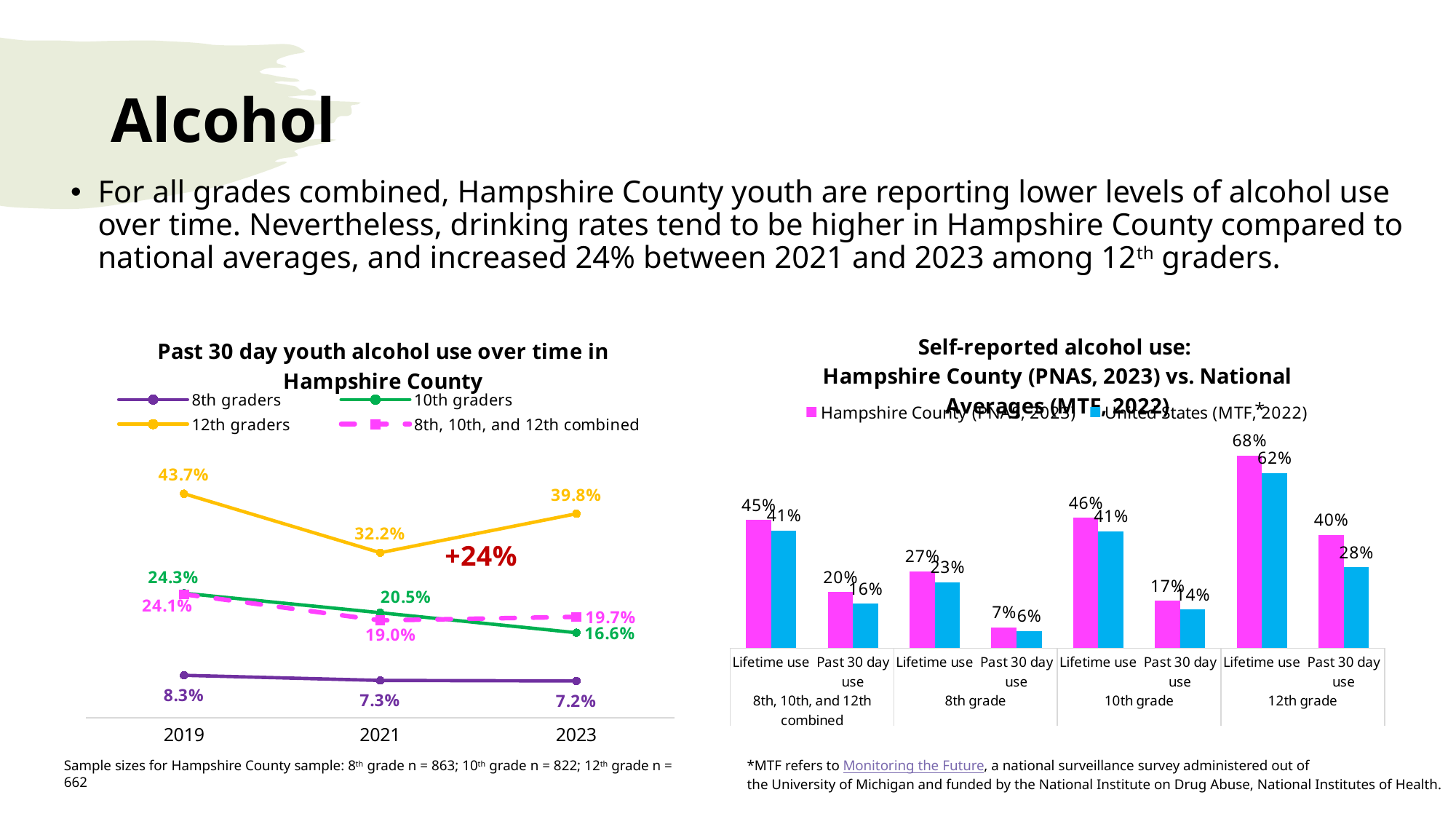
In the 'Self-reported alcohol use' chart on the right, what is the United States value for past 30 day use among 8th graders? 6% In the 'Self-reported alcohol use' chart on the right, what is the Hampshire County value for lifetime use among 12th graders? 68% In the 'Past 30 day youth alcohol use over time in Hampshire County' chart, what is the difference between the 12th graders' values in 2019 and 2021? 11.5% How many series does the legend of the 'Past 30 day youth alcohol use over time in Hampshire County' chart list? 4 What kind of chart is the 'Past 30 day youth alcohol use over time in Hampshire County' chart? Line chart In the 'Past 30 day youth alcohol use over time in Hampshire County' chart, what is the value for 10th graders in 2023? 16.6% In the 'Past 30 day youth alcohol use over time in Hampshire County' chart, which year has the lowest value for 8th graders? 2023 In the 'Self-reported alcohol use' chart on the right, which is larger for lifetime use among 10th graders: Hampshire County or United States? Hampshire County In the 'Past 30 day youth alcohol use over time in Hampshire County' chart, what is the value for 12th graders in 2019? 43.7% In the 'Self-reported alcohol use' chart on the right, what is the difference between the Hampshire County and United States values for past 30 day use among 12th graders? 12% In the 'Past 30 day youth alcohol use over time in Hampshire County' chart, how do the values for 10th graders change from 2019 to 2023? They fall What kind of chart is the 'Self-reported alcohol use' chart on the right? Bar chart